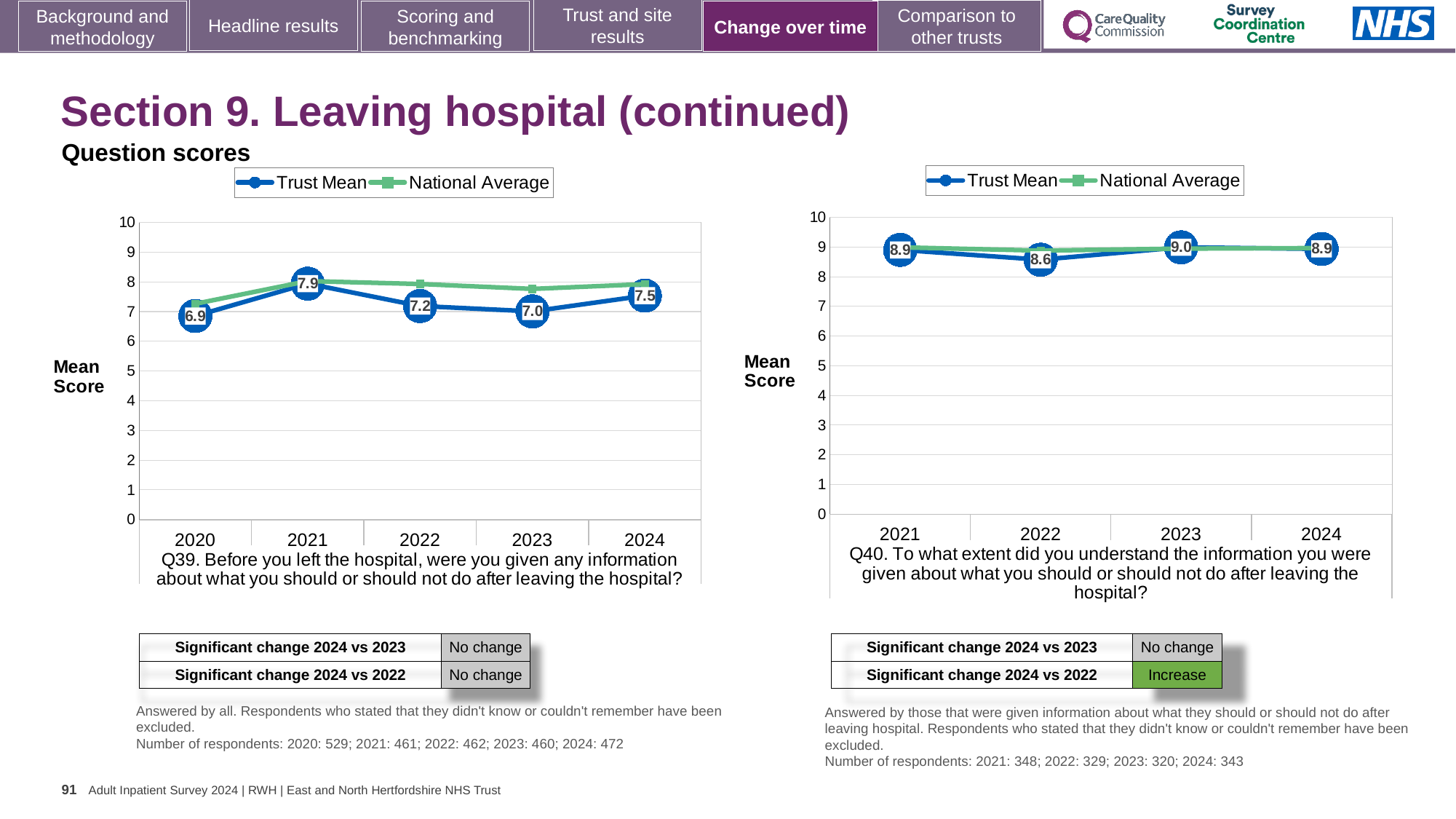
In the Q39 chart on the left, what is the Trust Mean score for 2024? 7.5 How many years are plotted on the x axis of the Q40 chart on the right? 4 In the Q40 chart on the right, what is the Trust Mean score for 2022? 8.6 In the Q39 chart on the left, what is the difference between the Trust Mean scores for 2021 and 2020? 1.0 In the Q40 chart on the right, is the Trust Mean score for 2023 larger or smaller than the score for 2022? larger In the Q39 chart on the left, what is the Trust Mean score for 2021? 7.9 In the Q39 chart on the left, is the National Average for 2020 greater or less than 8? less In the Q39 chart on the left, which year has the highest Trust Mean score? 2021 In the Q40 chart on the right, which year has the highest Trust Mean score? 2023 What kind of chart is the Q40 chart on the right? Line chart How many series does the legend of the Q39 chart on the left list? 2 In the Q39 chart on the left, which year has the lowest Trust Mean score? 2020